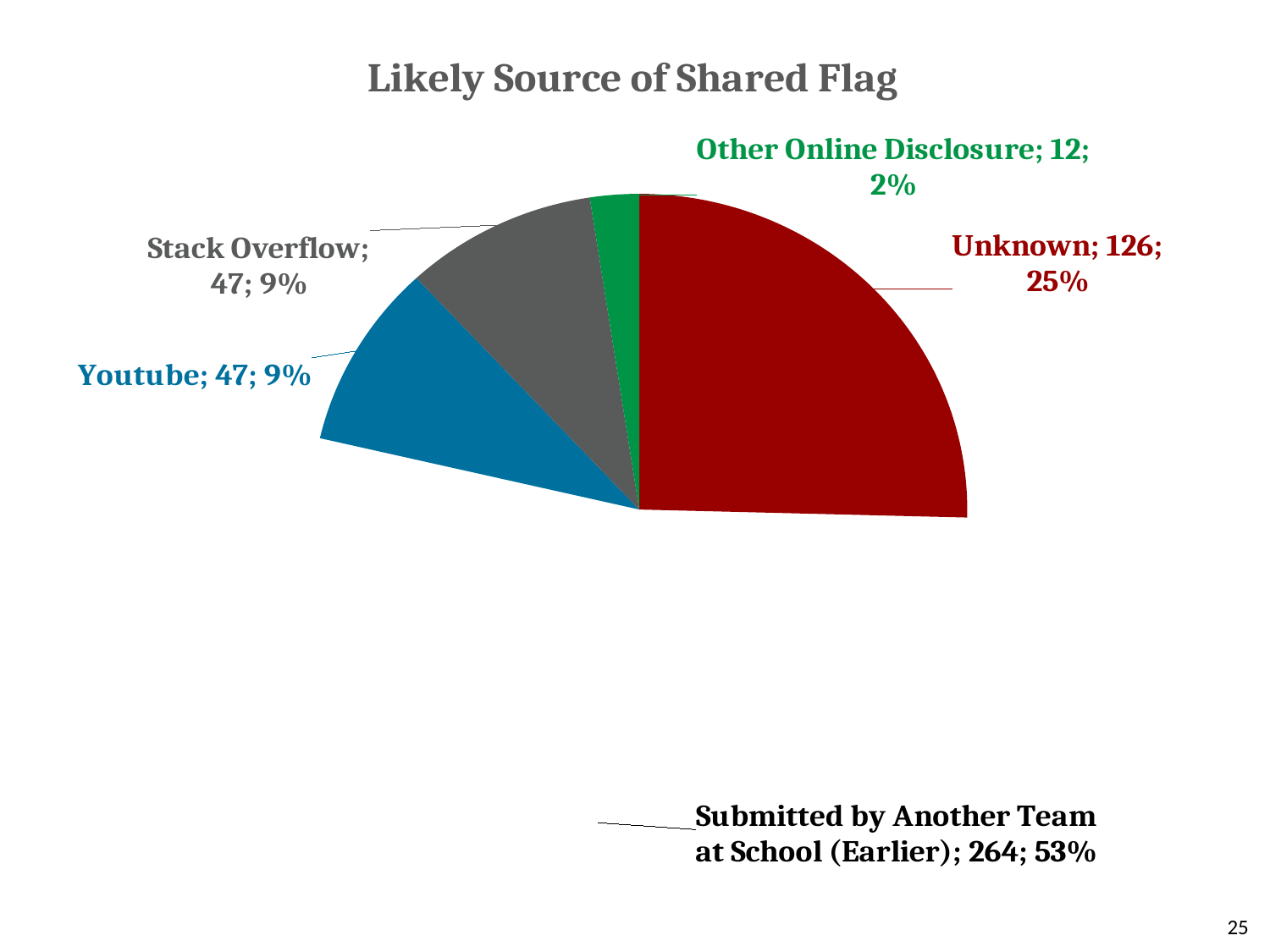
Which category has the largest share of the pie? Submitted by Another Team at School (Earlier) What is the count for Other Online Disclosure? 12 What percentage share does Submitted by Another Team at School (Earlier) have? 53% Which category has the smallest share of the pie? Other Online Disclosure What is the difference in count between Unknown and Stack Overflow? 79 What is the count for Unknown? 126 How many categories are labelled on the pie chart? 5 What percentage share does Stack Overflow have? 9% What percentage share does Unknown have? 25% Which is larger, the count for Unknown or the count for Youtube? Unknown What kind of chart is shown on the slide? pie chart What is the title of the chart? Likely Source of Shared Flag